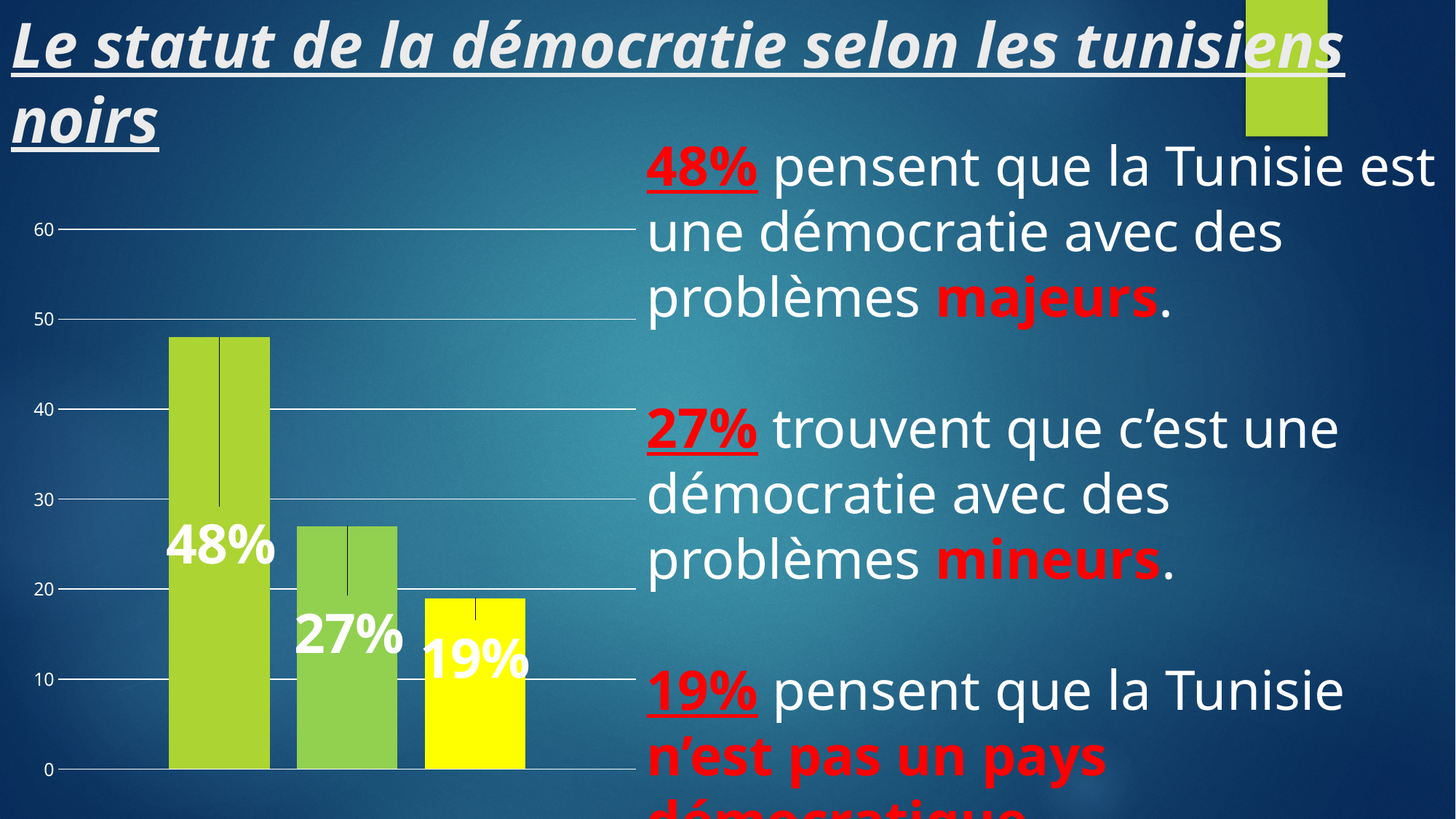
What is the highest tick value shown on the vertical axis of the chart? 60 Do the bar values rise or fall from left to right across the chart? fall What is the difference between the values of the middle bar and the rightmost bar? 8% What is the value shown on the middle bar of the chart? 27% What kind of chart is shown on the slide? bar chart What is the value shown on the yellow (rightmost) bar of the chart? 19% Which bar has the highest value in the chart? the first (leftmost) bar, 48% Which is larger, the value of the middle bar or the value of the rightmost bar? the middle bar (27%) What is the value shown on the first (leftmost) bar of the chart? 48% How many bars does the chart contain? 3 Which bar has the lowest value in the chart? the yellow (rightmost) bar, 19% What is the difference between the values of the first bar and the middle bar? 21%